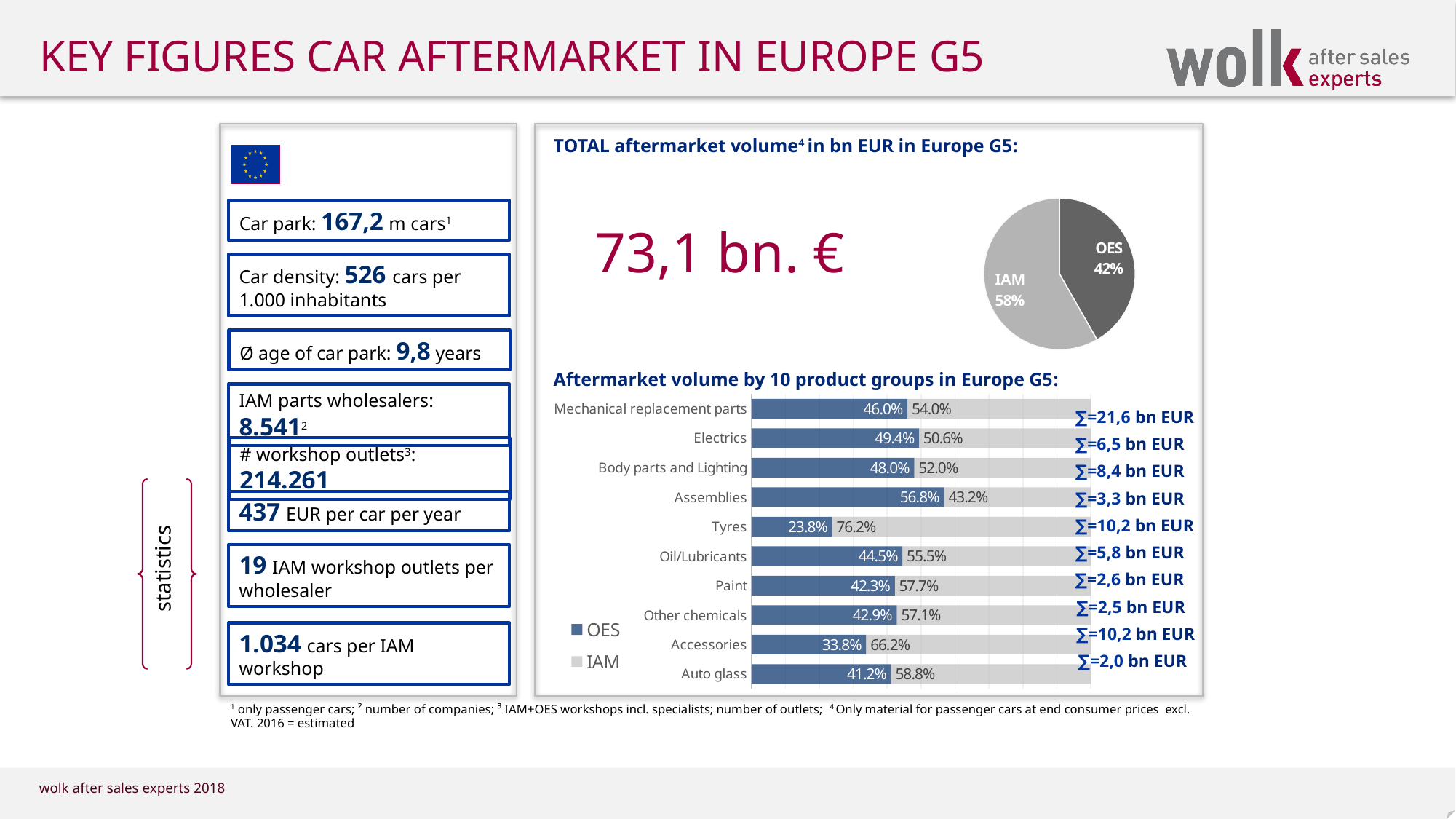
What kind of chart is used to show aftermarket volume by 10 product groups? Bar chart In the pie chart for total aftermarket volume, what share does IAM have? 58% In the bar chart of aftermarket volume by 10 product groups, how many product groups are shown? 10 In the bar chart of aftermarket volume by 10 product groups, what is the OES share for Tyres? 23.8% In the bar chart of aftermarket volume by 10 product groups, what is the IAM share for Assemblies? 43.2% In the bar chart of aftermarket volume by 10 product groups, how many series does the legend list? 2 In the pie chart for total aftermarket volume, which slice is larger, IAM or OES? IAM In the bar chart of aftermarket volume by 10 product groups, what is the total volume shown for Mechanical replacement parts? 21,6 bn EUR In the pie chart for total aftermarket volume, what share does OES have? 42% In the bar chart of aftermarket volume by 10 product groups, what is the difference between the IAM share and the OES share for Accessories? 32.4% In the bar chart of aftermarket volume by 10 product groups, which product group has the highest OES share? Assemblies In the bar chart of aftermarket volume by 10 product groups, which product group has the lowest OES share? Tyres